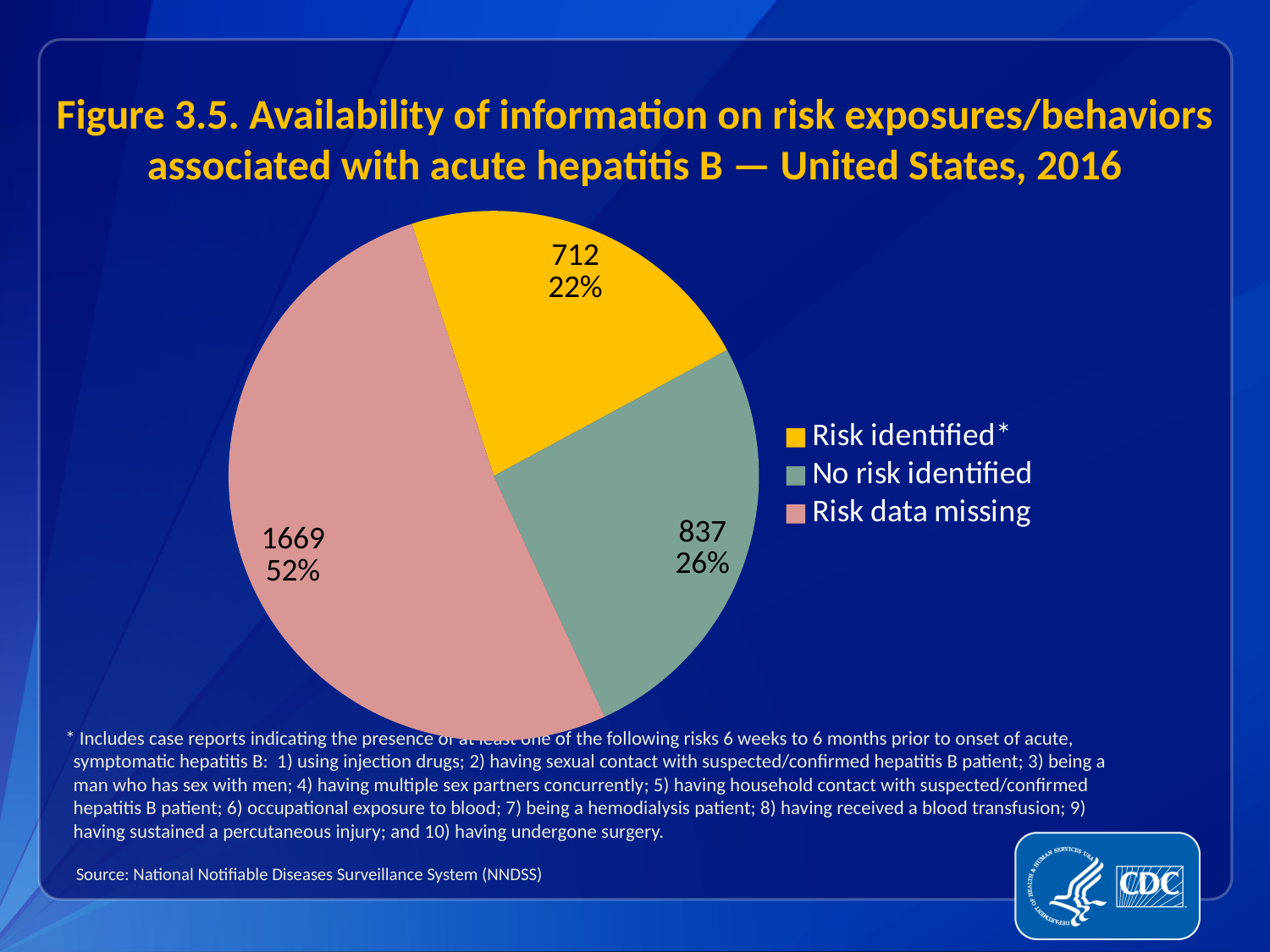
What kind of chart is shown on the slide? pie chart How many cases are in the "Risk data missing" slice? 1669 What percentage of the pie is "Risk data missing"? 52% What percentage of the pie is "No risk identified"? 26% Which is larger, the "No risk identified" slice or the "Risk identified*" slice? No risk identified How many categories does the legend list? 3 Which category has the largest slice of the pie? Risk data missing Which category has the smallest slice of the pie? Risk identified* What is the total number of cases across all three slices? 3218 What colour is the "Risk identified*" slice? yellow How many cases are in the "Risk identified*" slice? 712 What is the difference in cases between "Risk data missing" and "No risk identified"? 832